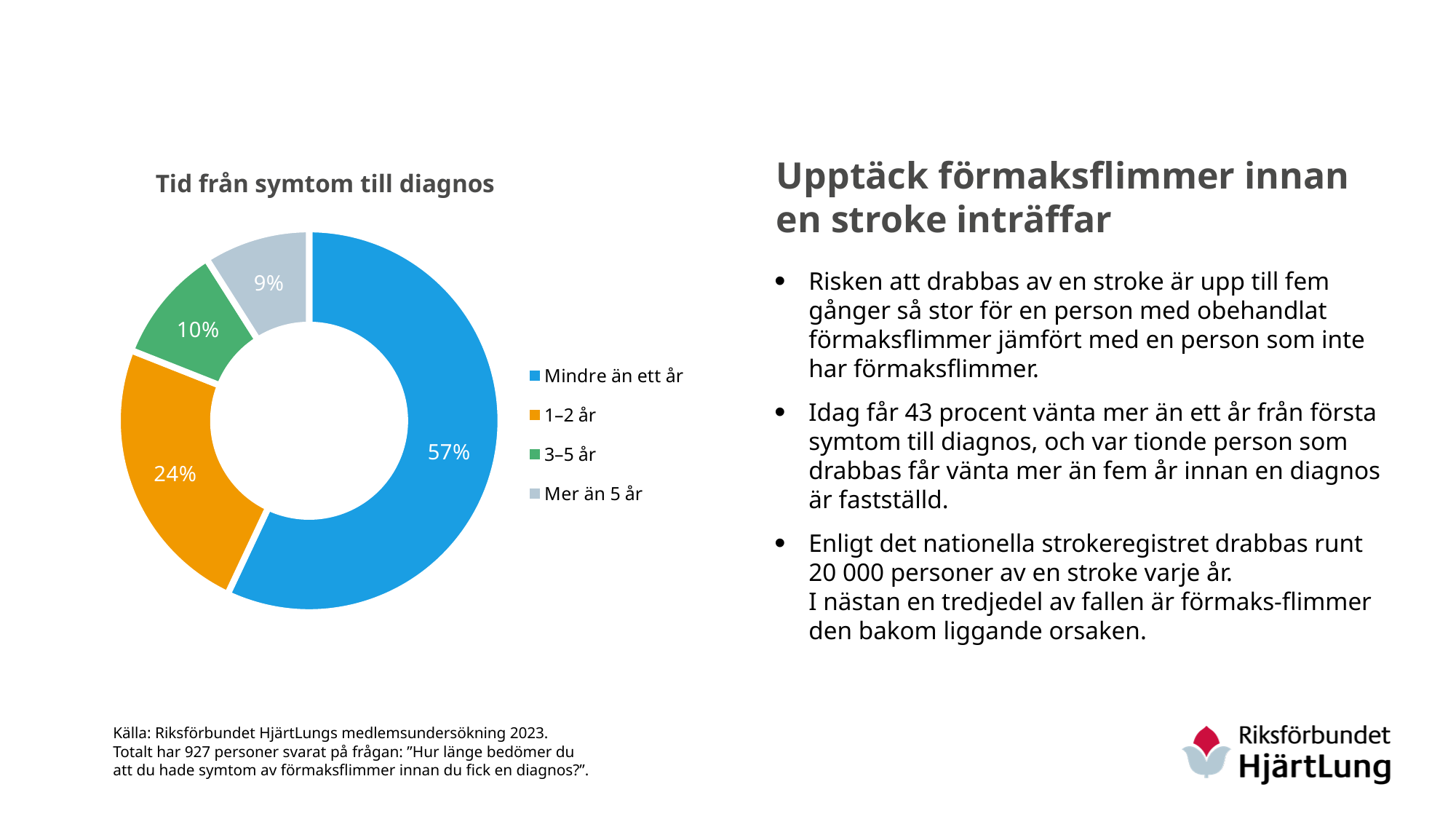
What kind of chart is shown on the slide? Pie chart (doughnut) What is the value for "1–2 år"? 24% What colour is the slice for "3–5 år"? Green Which category has the smallest share? Mer än 5 år Which is larger, the share for "1–2 år" or the share for "3–5 år"? 1–2 år What is the title of the chart? Tid från symtom till diagnos How many categories does the chart show? 4 Which category has the largest share? Mindre än ett år What is the value for "Mer än 5 år"? 9% What is the difference between the shares for "Mindre än ett år" and "1–2 år"? 33% What is the value for "3–5 år"? 10% What share of the pie does "Mindre än ett år" represent? 57%